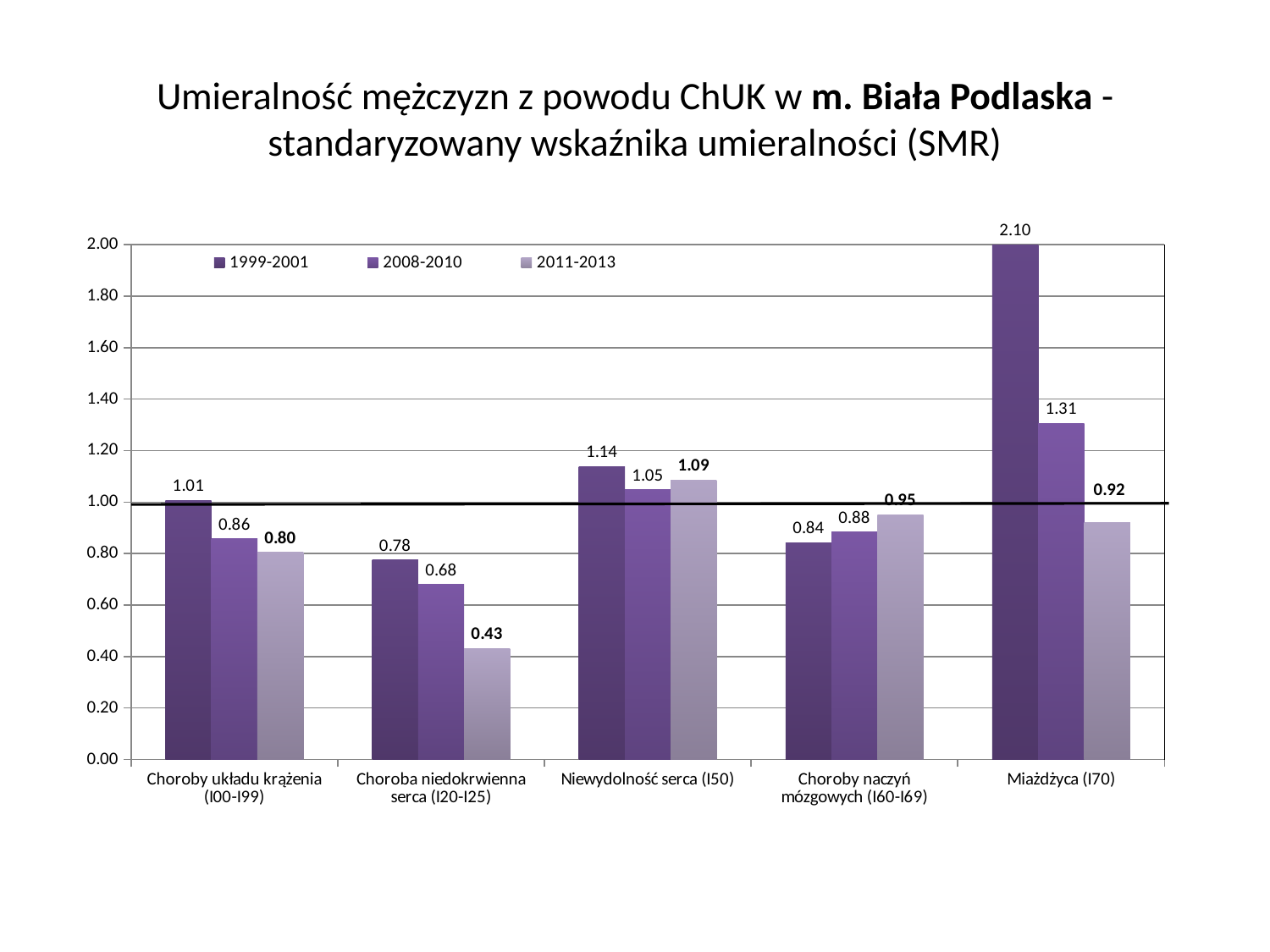
Which category has the lowest value in the 2011-2013 series? Choroba niedokrwienna serca (I20-I25) Which category has the highest value in the 1999-2001 series? Miażdżyca (I70) What is the difference between the 1999-2001 and 2011-2013 values for Miażdżyca (I70)? 1.18 How many categories are shown on the x axis? 5 Is the 2008-2010 value for Miażdżyca (I70) greater or less than 1.00? greater Do the values for Choroby układu krążenia (I00-I99) rise or fall across the three periods from 1999-2001 to 2011-2013? fall What is the value for Niewydolność serca (I50) in the 2008-2010 series? 1.05 What kind of chart is shown on the slide? bar chart Which is larger for Choroby naczyń mózgowych (I60-I69): the 1999-2001 value or the 2011-2013 value? 2011-2013 What is the value for Choroba niedokrwienna serca (I20-I25) in the 2011-2013 series? 0.43 How many series does the legend list? 3 What is the value for Miażdżyca (I70) in the 1999-2001 series? 2.10